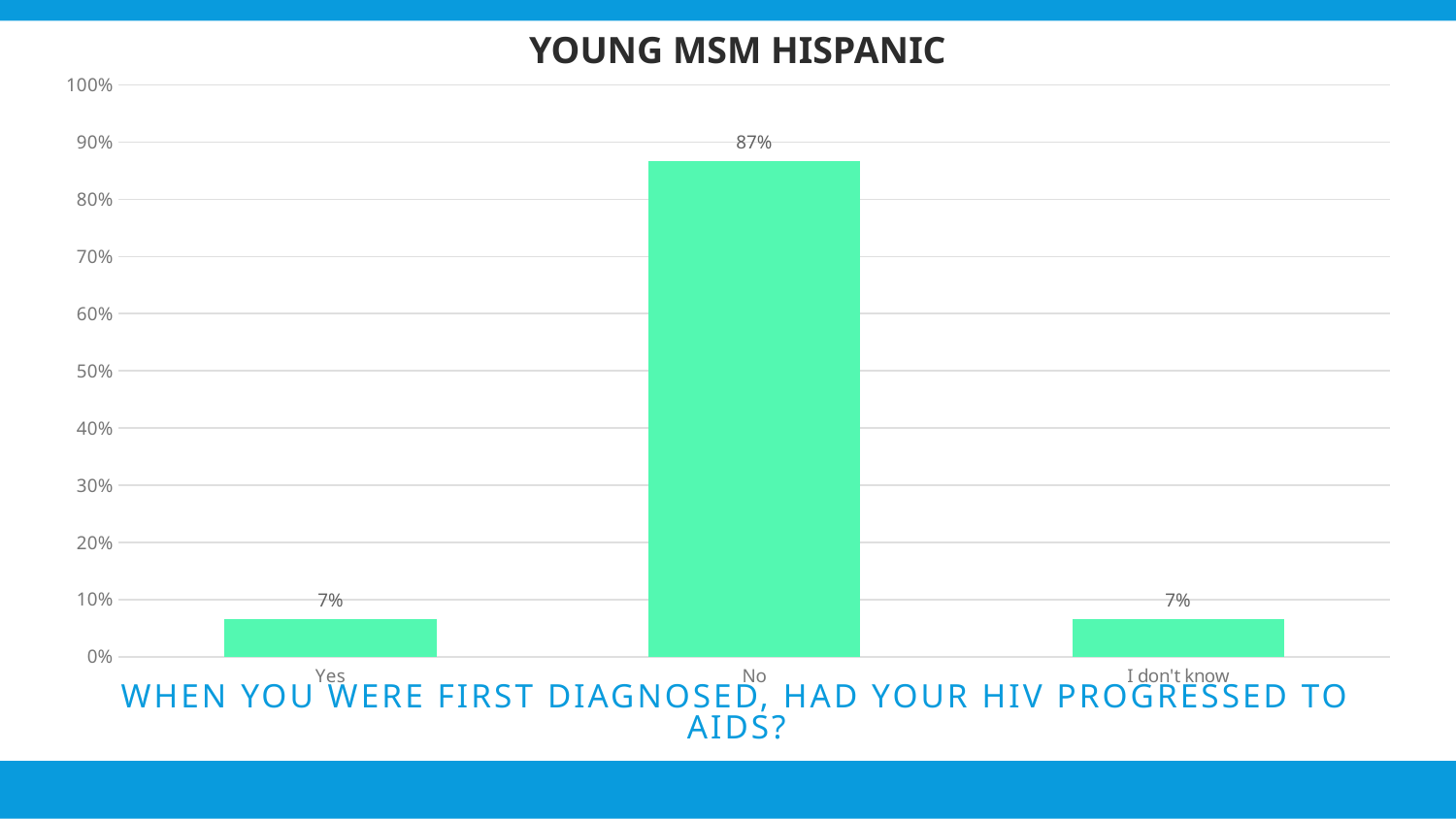
What is the difference between the values for "No" and "Yes"? 80% What is the value for "I don't know"? 7% What is the value for "Yes"? 7% Is the value for "Yes" greater or less than 10%? less Which category has the highest value? No What is the highest value shown on the y axis? 100% What kind of chart is shown on the slide? Bar chart Is the value for "No" greater or less than 80%? greater How many categories are shown on the x axis? 3 Which is larger, the value for "No" or the value for "I don't know"? No What is the title of the chart? YOUNG MSM HISPANIC What is the value for "No"? 87%